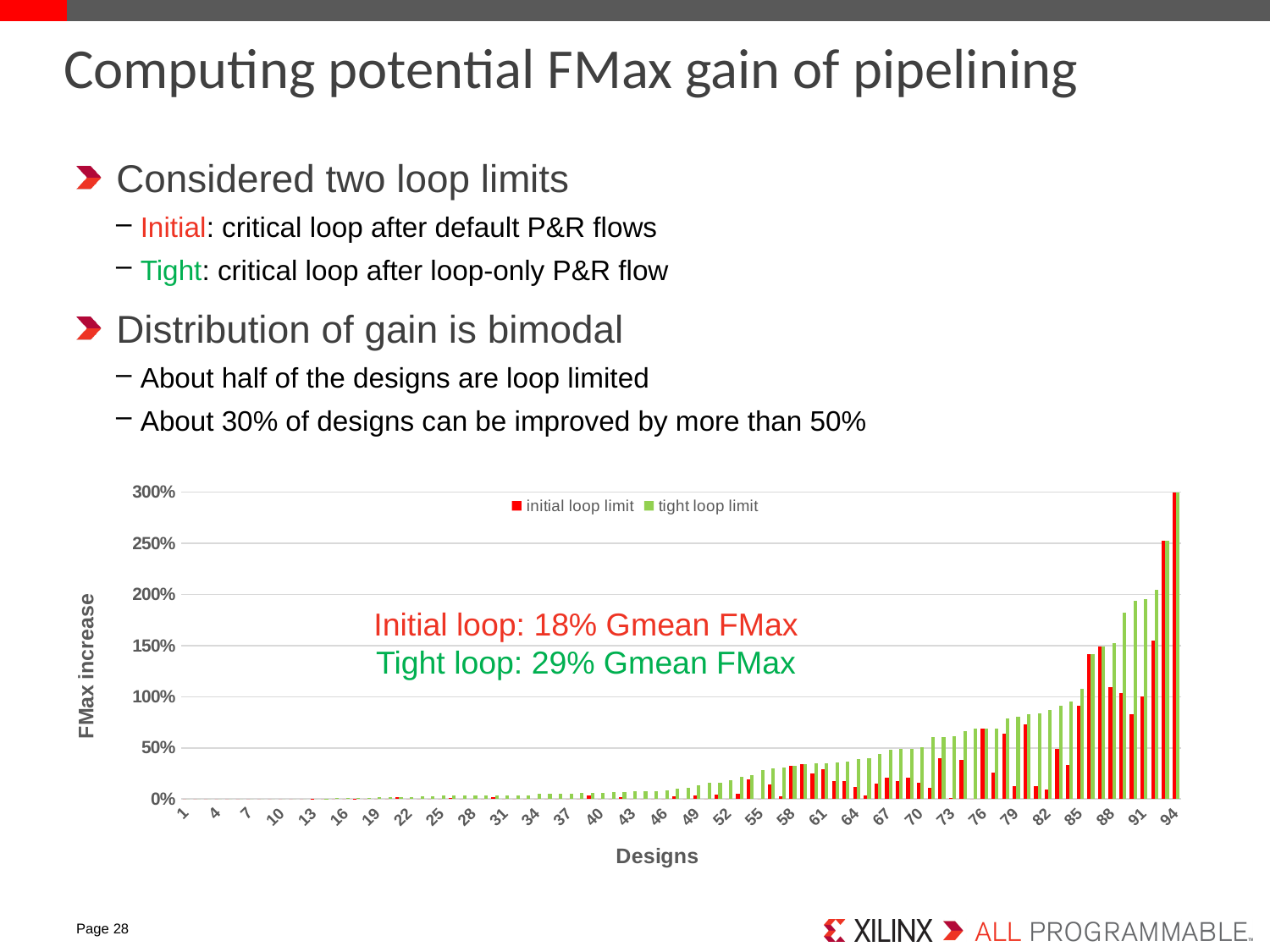
What is the label of the chart's y axis? FMax increase Is the initial loop limit value for design 40 greater or less than 50%? less What kind of chart is shown on the slide? bar chart Which design has the highest FMax increase in the chart? 94 Which colour represents the tight loop limit series in the chart? green How many series does the chart legend list? 2 What are the two series named in the chart legend? initial loop limit and tight loop limit What is the label of the chart's x axis? Designs According to the text on the chart, what is the Gmean FMax gain for the initial loop? 18% Is the tight loop limit value for design 94 greater or less than 250%? greater According to the text on the chart, what is the Gmean FMax gain for the tight loop? 29% Do the FMax increase values rise or fall as you move from design 1 to design 94 along the x axis? rise